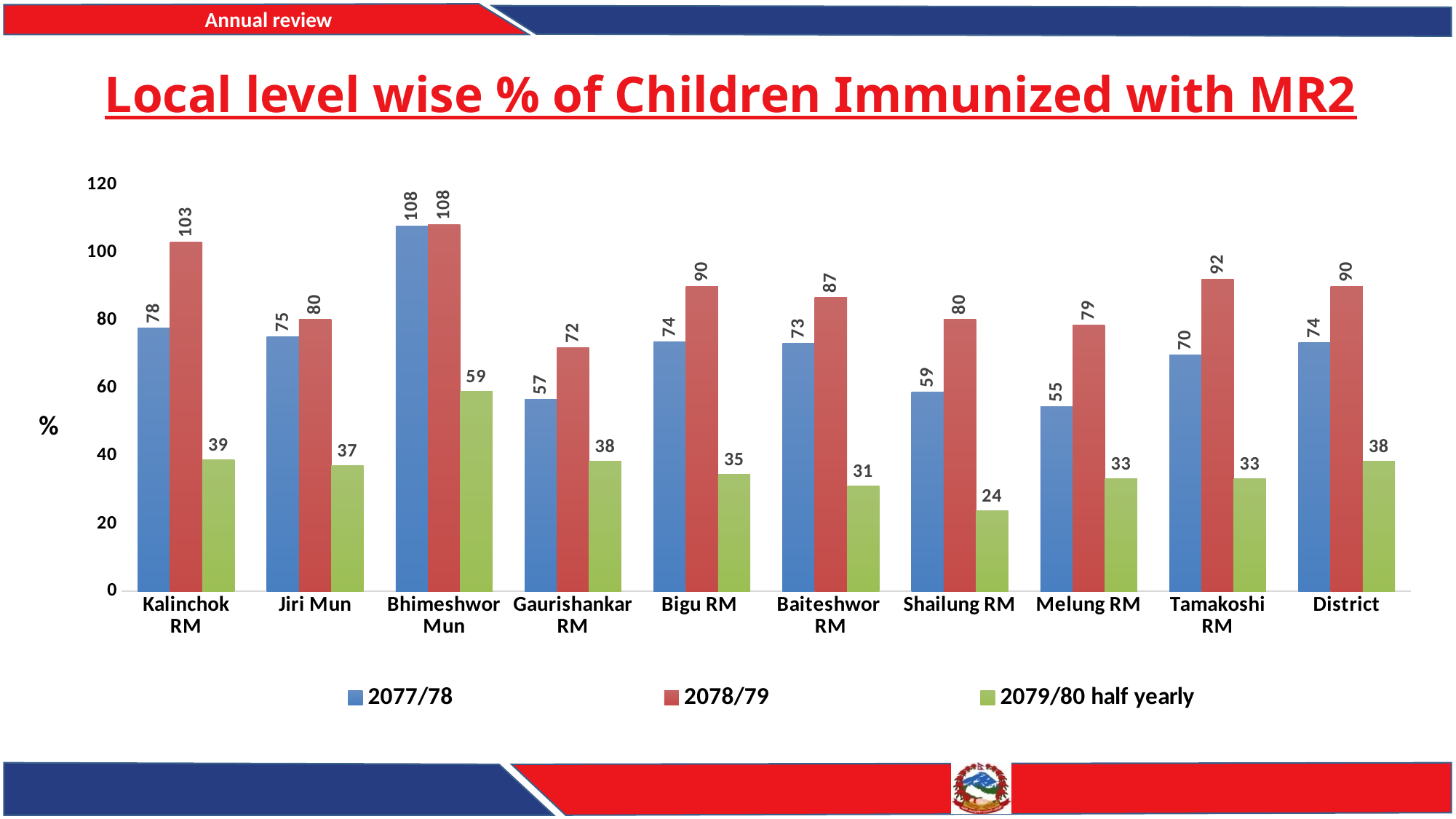
What is the value for Shailung RM in the 2079/80 half yearly series? 24 What kind of chart is shown on the slide? bar chart Which category has the highest value in the 2078/79 series? Bhimeshwor Mun What is the value for Tamakoshi RM in the 2077/78 series? 70 Which is larger for Melung RM: the 2077/78 value or the 2079/80 half yearly value? 2077/78 What is the difference between the 2078/79 and 2077/78 values for Bigu RM? 16 Is the 2078/79 value for Gaurishankar RM greater or less than 80? less What is the value for Kalinchok RM in the 2078/79 series? 103 Which category has the lowest value in the 2079/80 half yearly series? Shailung RM How many categories are shown on the x axis? 10 How many series does the legend list? 3 What is the title of the chart? Local level wise % of Children Immunized with MR2